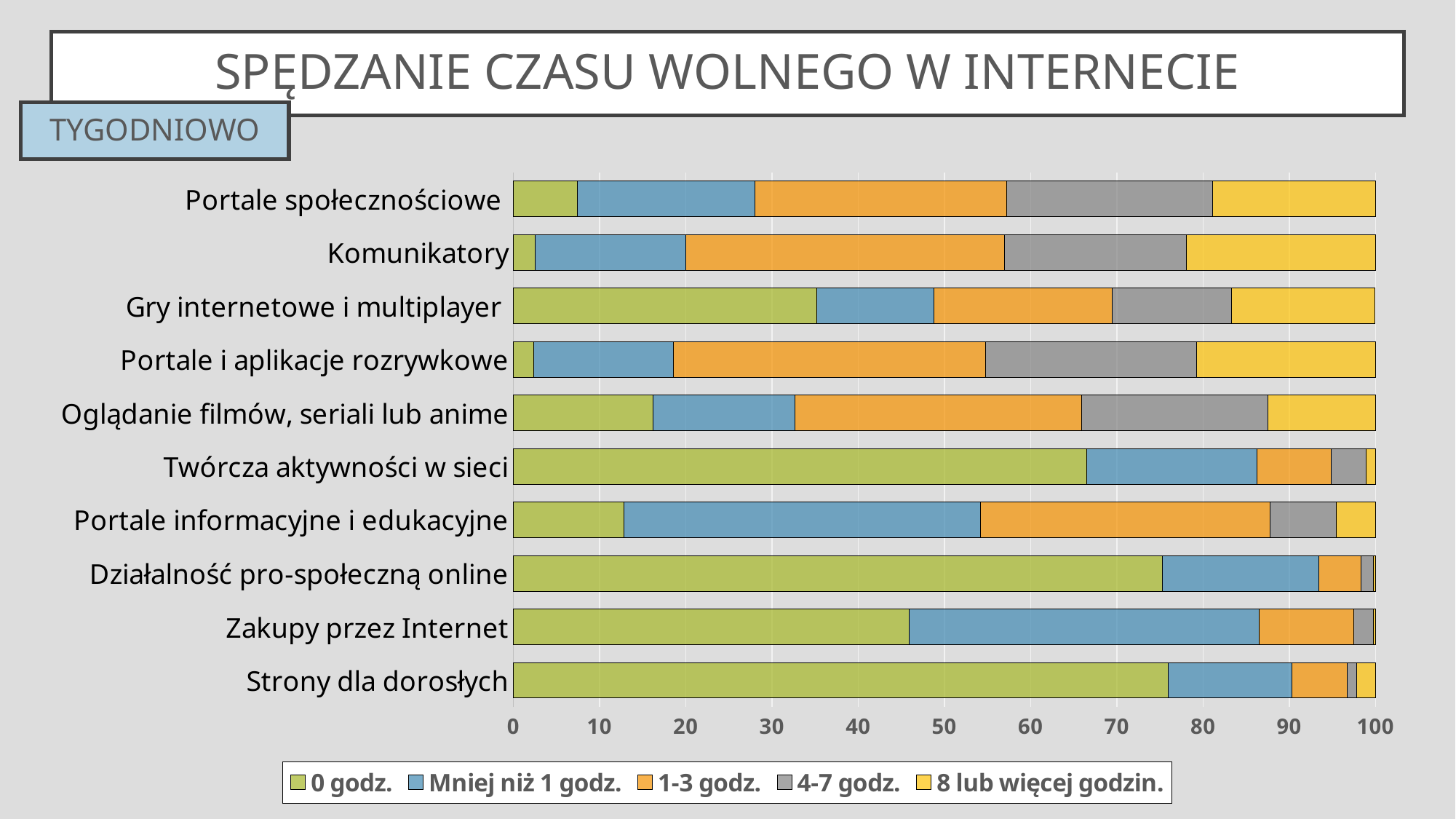
How many categories (activities) are plotted on the chart? 10 What kind of chart is shown on the slide? Stacked bar chart What is the title shown at the top of the slide? SPĘDZANIE CZASU WOLNEGO W INTERNECIE Which has the larger "8 lub więcej godzin." segment: Portale społecznościowe or Oglądanie filmów, seriali lub anime? Portale społecznościowe Which colour represents the "0 godz." series in the legend? Green Is the "0 godz." value for Portale społecznościowe greater or less than 10? less Is the "0 godz." value for Zakupy przez Internet greater or less than 50? less Is the "0 godz." value for Twórcza aktywności w sieci greater or less than 60? greater Which has the larger "0 godz." segment: Gry internetowe i multiplayer or Zakupy przez Internet? Zakupy przez Internet How many series does the legend list? 5